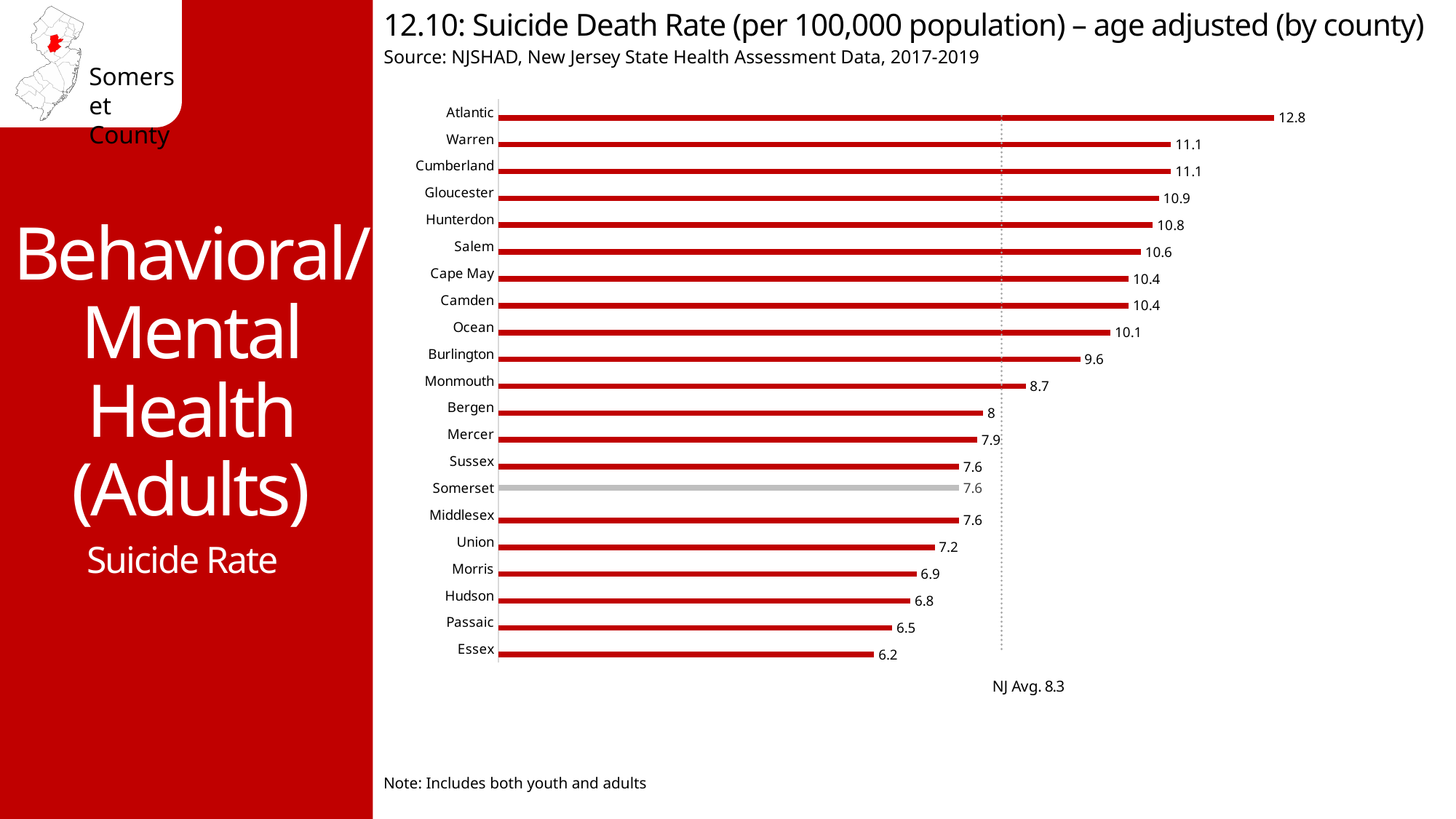
Which county has the lowest suicide death rate? Essex What is the difference between the suicide death rates of Somerset and Monmouth counties? 1.1 Which county has the highest suicide death rate? Atlantic Which county has a higher suicide death rate, Morris or Union? Union What is the suicide death rate for Hunterdon County? 10.8 What is the difference between the suicide death rates of Atlantic and Essex counties? 6.6 What type of chart is shown on the slide? Bar chart Which county has a higher suicide death rate, Burlington or Bergen? Burlington What is the suicide death rate for Atlantic County? 12.8 What is the suicide death rate for Somerset County? 7.6 What is the NJ average suicide death rate shown on the chart? 8.3 How many counties are shown in the chart? 21